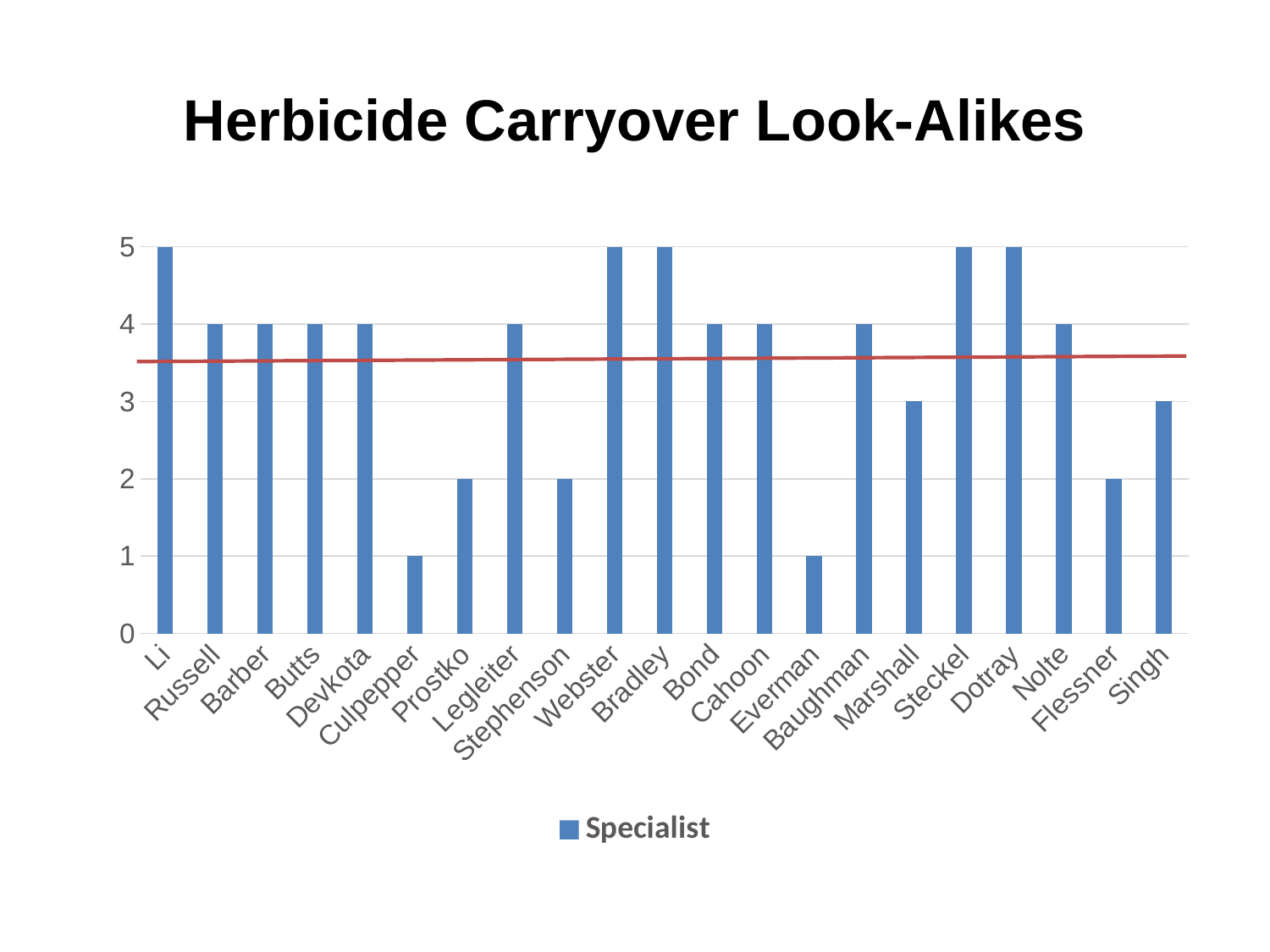
What is the value for Li? 5 What is the value for Flessner? 2 How many categories (names) are shown on the x axis? 21 Which is larger, the value for Bradley or the value for Prostko? Bradley What is the difference between the values for Webster and Everman? 4 Is the value for Stephenson greater or less than 3? less What is the title of the chart? Herbicide Carryover Look-Alikes What type of chart is shown on the slide? Bar chart What is the name of the series shown in the legend? Specialist What is the value for Marshall? 3 How many series does the legend list? 1 What is the value for Culpepper? 1